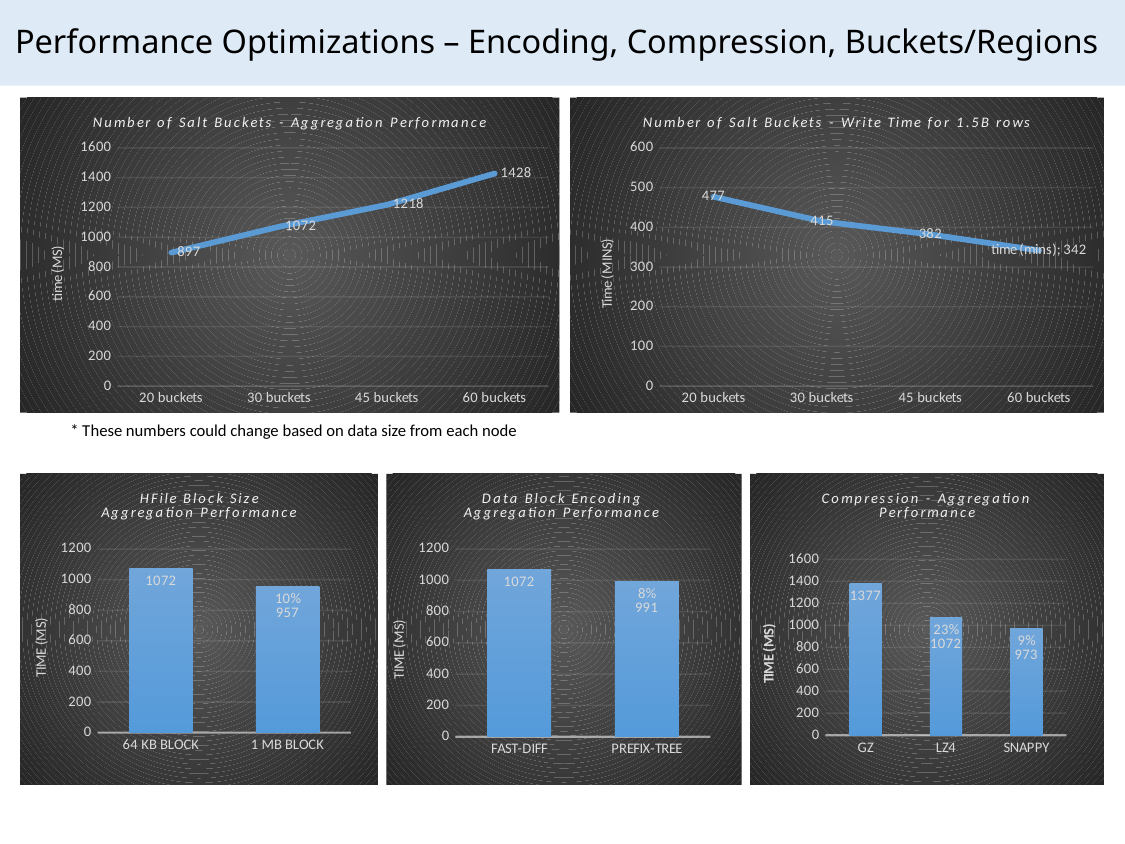
In the 'Number of Salt Buckets - Aggregation Performance' chart, what is the difference between the values for 60 buckets and 20 buckets? 531 In the 'Compression - Aggregation Performance' chart, what is the value for SNAPPY? 973 In the 'Data Block Encoding Aggregation Performance' chart, what is the difference between FAST-DIFF and PREFIX-TREE? 81 In the 'Data Block Encoding Aggregation Performance' chart, which category has the higher value, FAST-DIFF or PREFIX-TREE? FAST-DIFF In the 'HFile Block Size Aggregation Performance' chart, what is the value for 1 MB BLOCK? 957 In the 'Number of Salt Buckets - Aggregation Performance' chart, what is the value for 45 buckets? 1218 In the 'Number of Salt Buckets - Write Time for 1.5B rows' chart, how many data points are plotted? 4 In the 'Compression - Aggregation Performance' chart, which compression has the highest value? GZ In the 'Number of Salt Buckets - Write Time for 1.5B rows' chart, what is the value for 30 buckets? 415 What kind of chart is the 'HFile Block Size Aggregation Performance' chart? bar chart In the 'Number of Salt Buckets - Aggregation Performance' chart, do the values rise or fall as the number of buckets increases? rise In the 'Number of Salt Buckets - Write Time for 1.5B rows' chart, which number of buckets has the lowest write time? 60 buckets